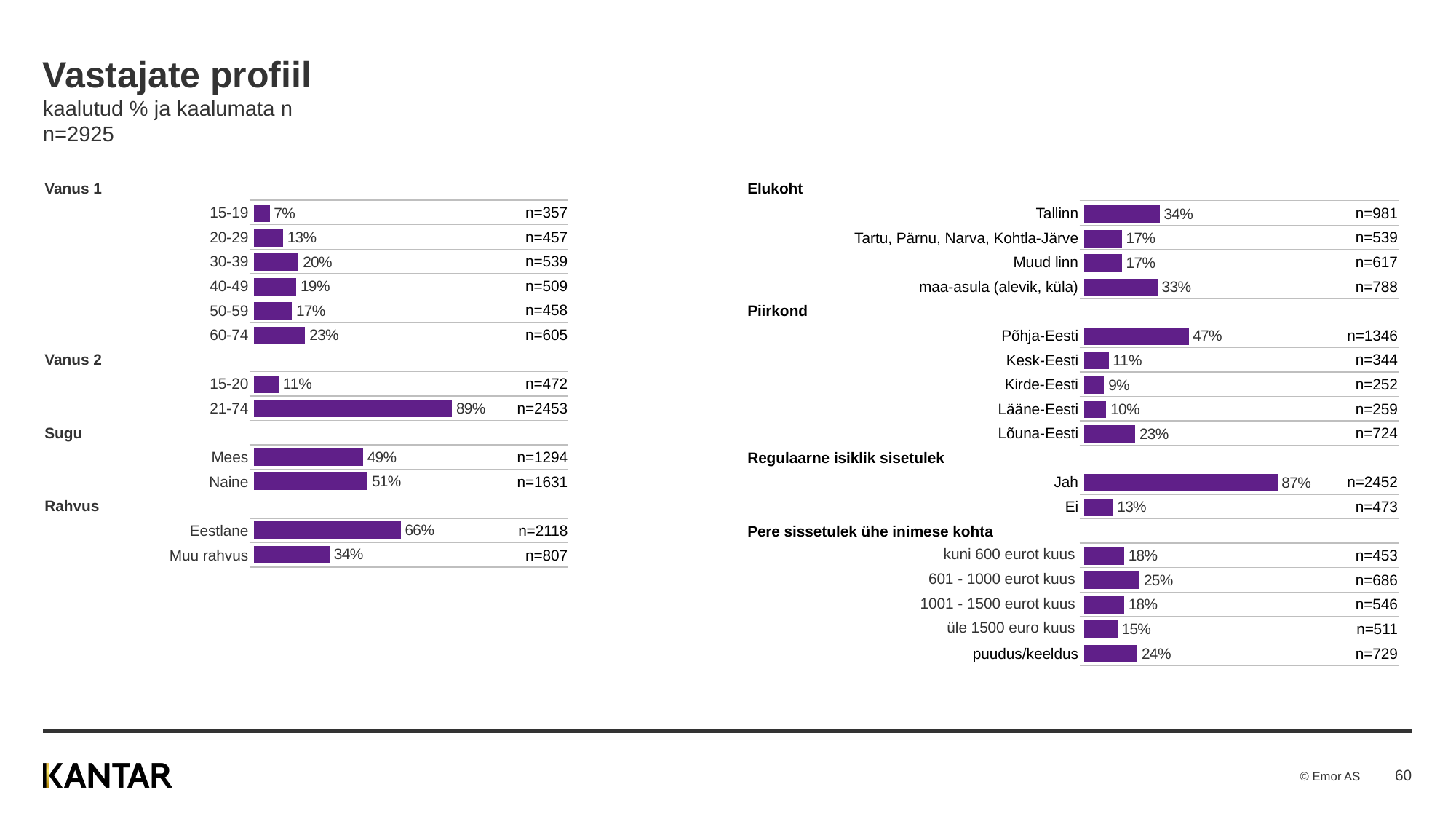
In the right chart, what is the n for Tallinn under Elukoht? n=981 In the left chart, what is the value for the 60-74 age group under Vanus 1? 23% In the right chart, what is the value for Põhja-Eesti under Piirkond? 47% In the right chart, how many categories are listed under Pere sissetulek ühe inimese kohta? 5 In the right chart, what is the difference in percentage points between Jah and Ei under Regulaarne isiklik sisetulek? 74 In the left chart, what is the difference in percentage points between Eestlane and Muu rahvus under Rahvus? 32 In the left chart, which Vanus 1 age group has the lowest percentage? 15-19 In the left chart, which is larger, the value for Mees or the value for Naine? Naine In the left chart, what is the n for Naine under Sugu? n=1631 In the left chart, how many age groups are listed under Vanus 1? 6 In the right chart, which Piirkond region has the highest percentage? Põhja-Eesti What type of chart is used on this slide? Bar chart